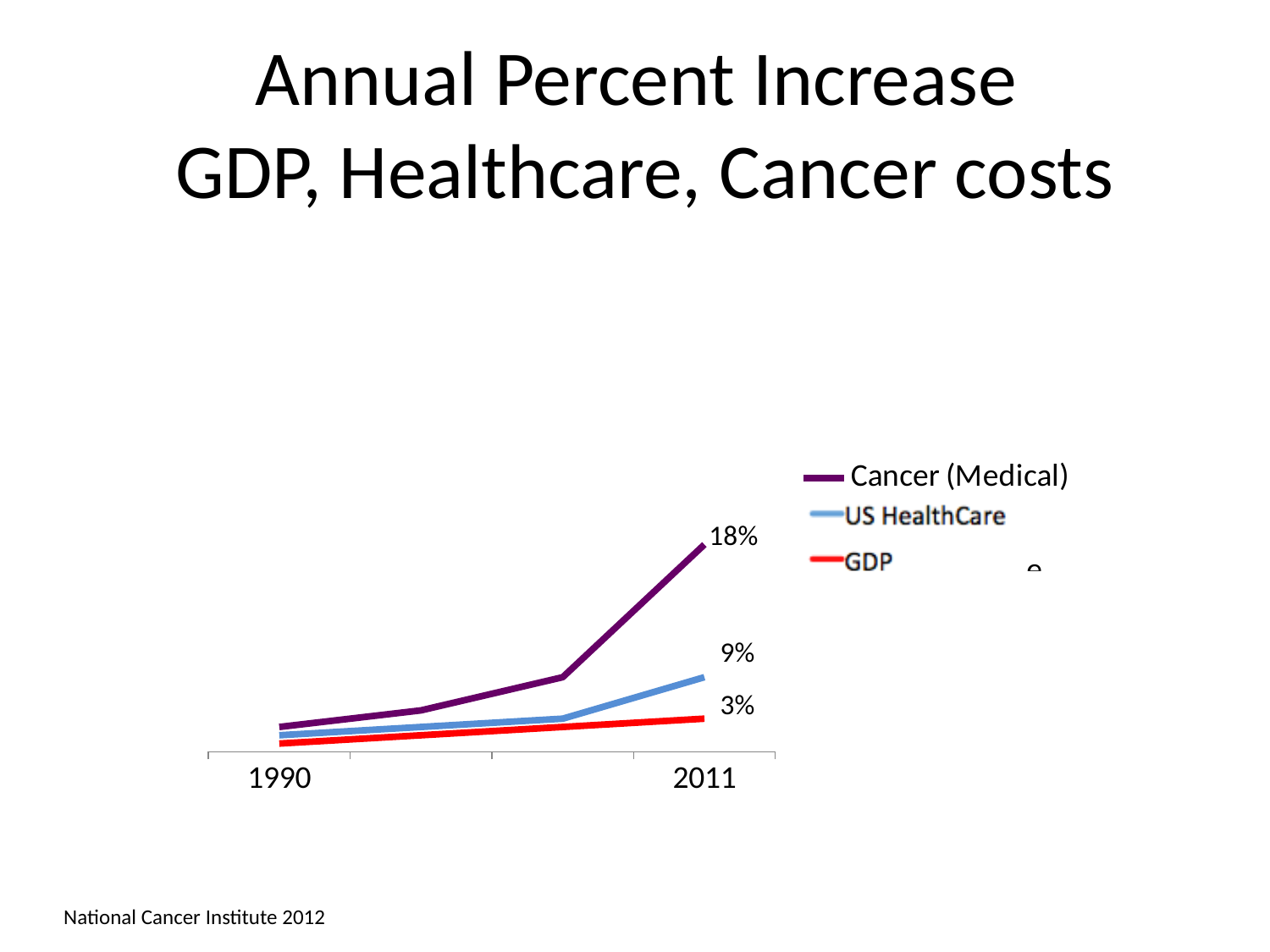
Does the Cancer (Medical) line rise or fall from 1990 to 2011? rise Which series has the lowest value in 2011? GDP How many series does the legend list? 3 What is the difference between the US HealthCare and GDP values in 2011? 6% Which series has the highest value in 2011? Cancer (Medical) What is the difference between the Cancer (Medical) and US HealthCare values in 2011? 9% What is the value labelled for US HealthCare in 2011? 9% What kind of chart is shown on the slide? line chart What is the value labelled for Cancer (Medical) in 2011? 18% What is the value labelled for GDP in 2011? 3% What is the first year labelled on the x axis? 1990 In 2011, which is larger: the Cancer (Medical) value or the GDP value? Cancer (Medical)